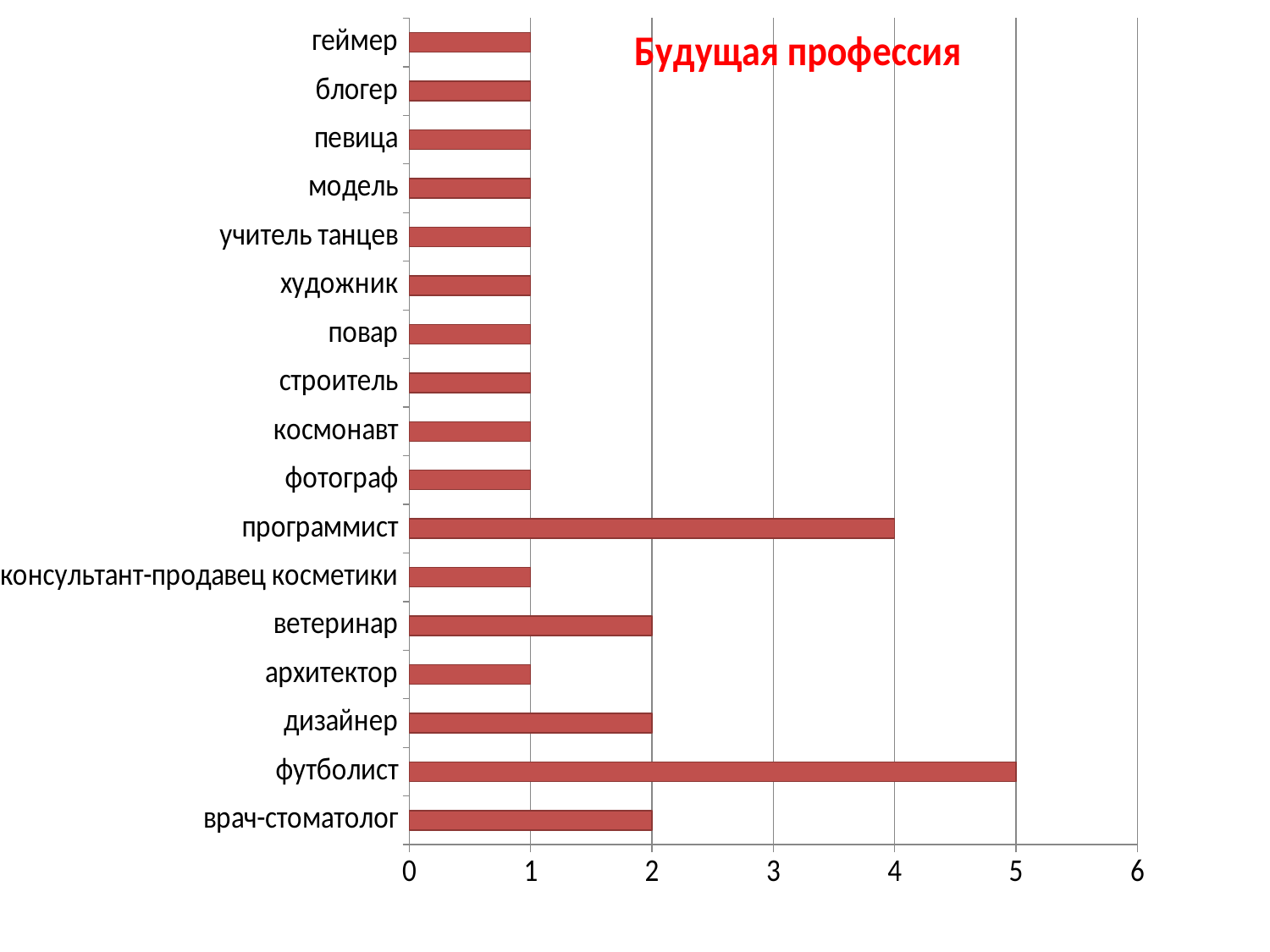
What type of chart is shown on the slide? bar chart Which profession has the highest value in the chart? футболист Is the value for программист greater or less than 3? greater What is the value for врач-стоматолог? 2 What is the title of the chart? Будущая профессия What is the difference between the values for футболист and программист? 1 Which is larger, the value for дизайнер or the value for архитектор? дизайнер How many professions (categories) are shown in the chart? 17 What is the value for футболист? 5 What is the value for программист? 4 What is the value for ветеринар? 2 What is the value for геймер? 1